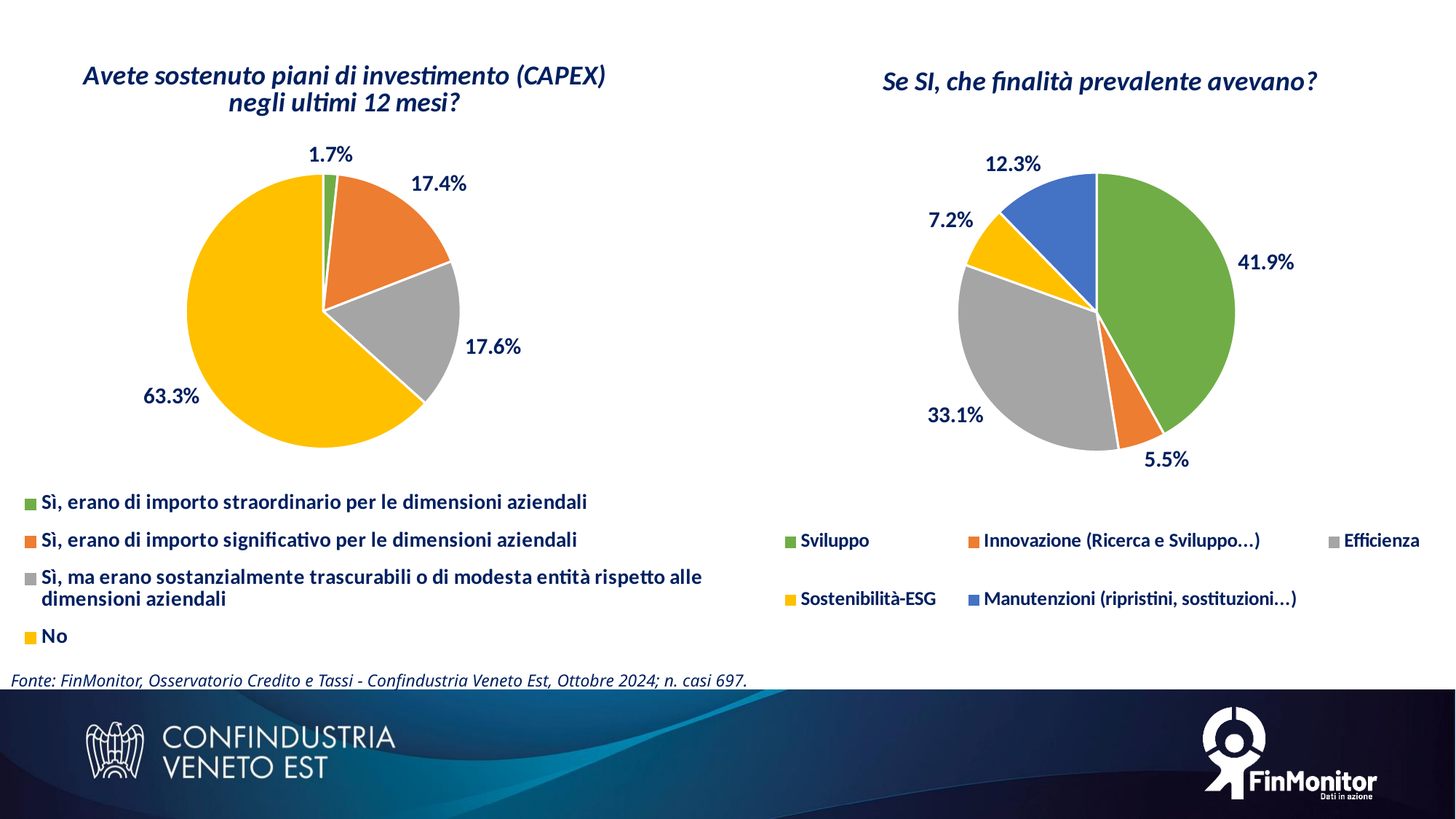
In the left pie chart, which category has the smallest slice? Sì, erano di importo straordinario per le dimensioni aziendali In the right pie chart, which category has the smallest share? Innovazione (Ricerca e Sviluppo…) What type of chart is used on the right side of the slide? Pie chart In the right pie chart, what is the difference between Sviluppo and Efficienza? 8.8% In the left pie chart, what is the value for "Sì, erano di importo straordinario per le dimensioni aziendali"? 1.7% In the left pie chart, which category has the largest slice? No In the right pie chart, what is the value for Manutenzioni (ripristini, sostituzioni…)? 12.3% In the right pie chart, which category has the largest share? Sviluppo In the left pie chart, how many categories are shown? 4 In the right pie chart (Se SI, che finalità prevalente avevano?), what is the value for Efficienza? 33.1% In the right pie chart, which is larger: Sostenibilità-ESG or Manutenzioni (ripristini, sostituzioni…)? Manutenzioni (ripristini, sostituzioni…) In the left pie chart (Avete sostenuto piani di investimento (CAPEX) negli ultimi 12 mesi?), what share of respondents answered "No"? 63.3%